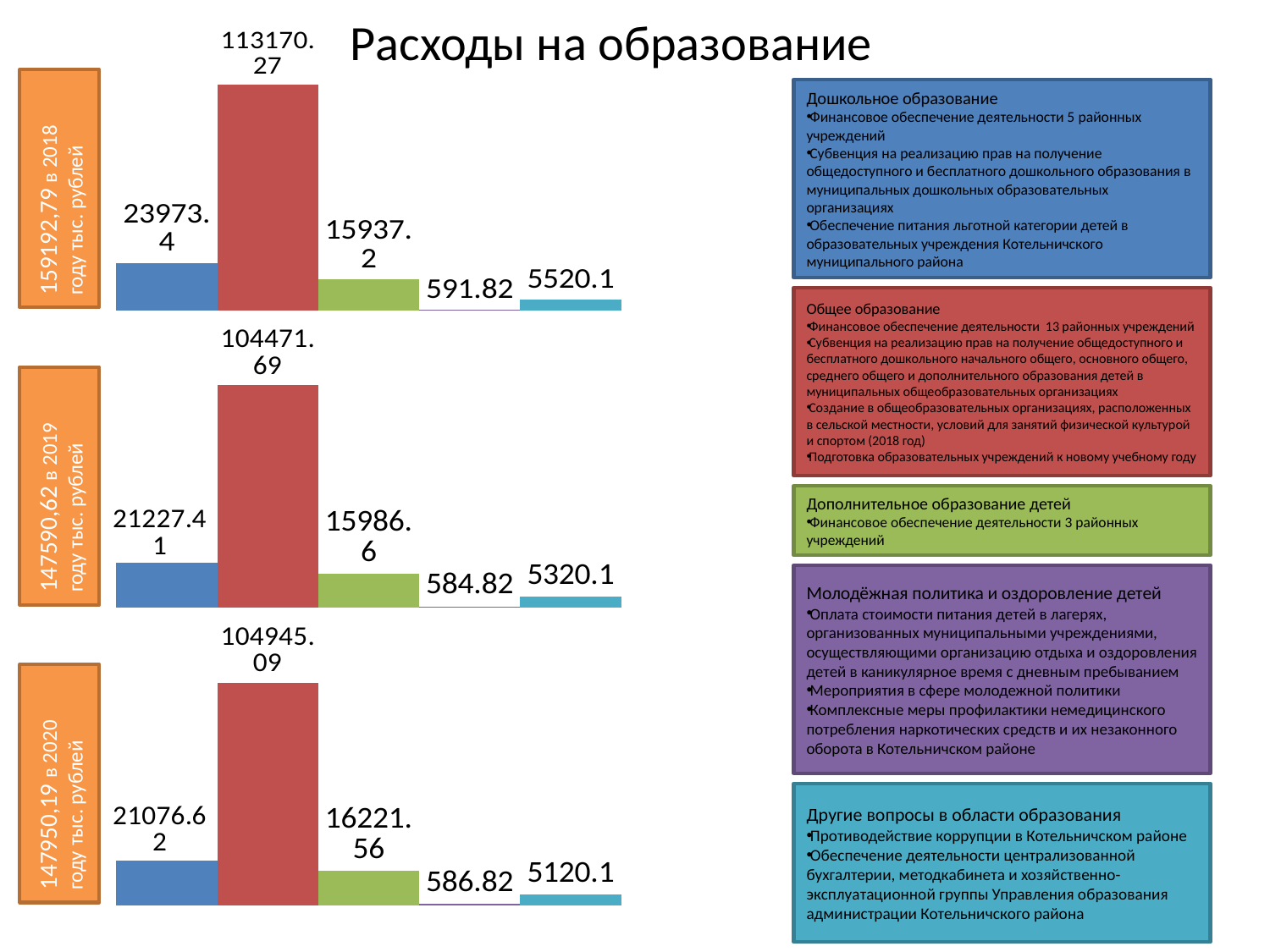
What is the total for 2019 shown in the orange label next to the middle chart? 147590,62 In the middle chart (2019), which bar has the lowest value? Молодёжная политика и оздоровление детей (purple bar) What is the title of the slide? Расходы на образование In the top chart (2018), what is the difference between the blue bar (23973.4) and the green bar (15937.2)? 8036.2 In the middle chart (2019), what is the value of the blue bar (Дошкольное образование)? 21227.41 In the top chart (2018), what is the value of the red bar (Общее образование)? 113170.27 In the bottom chart (2020), what is the value of the green bar (Дополнительное образование детей)? 16221.56 In the bottom chart (2020), which is larger: the blue bar (Дошкольное образование) or the cyan bar (Другие вопросы в области образования)? Дошкольное образование (blue bar) What type of chart is used on this slide? Bar chart In the top chart (2018), which bar has the highest value? Общее образование (red bar) How many bars are plotted in each of the three charts? 5 In the bottom chart (2020), what is the value of the cyan bar (Другие вопросы в области образования)? 5120.1